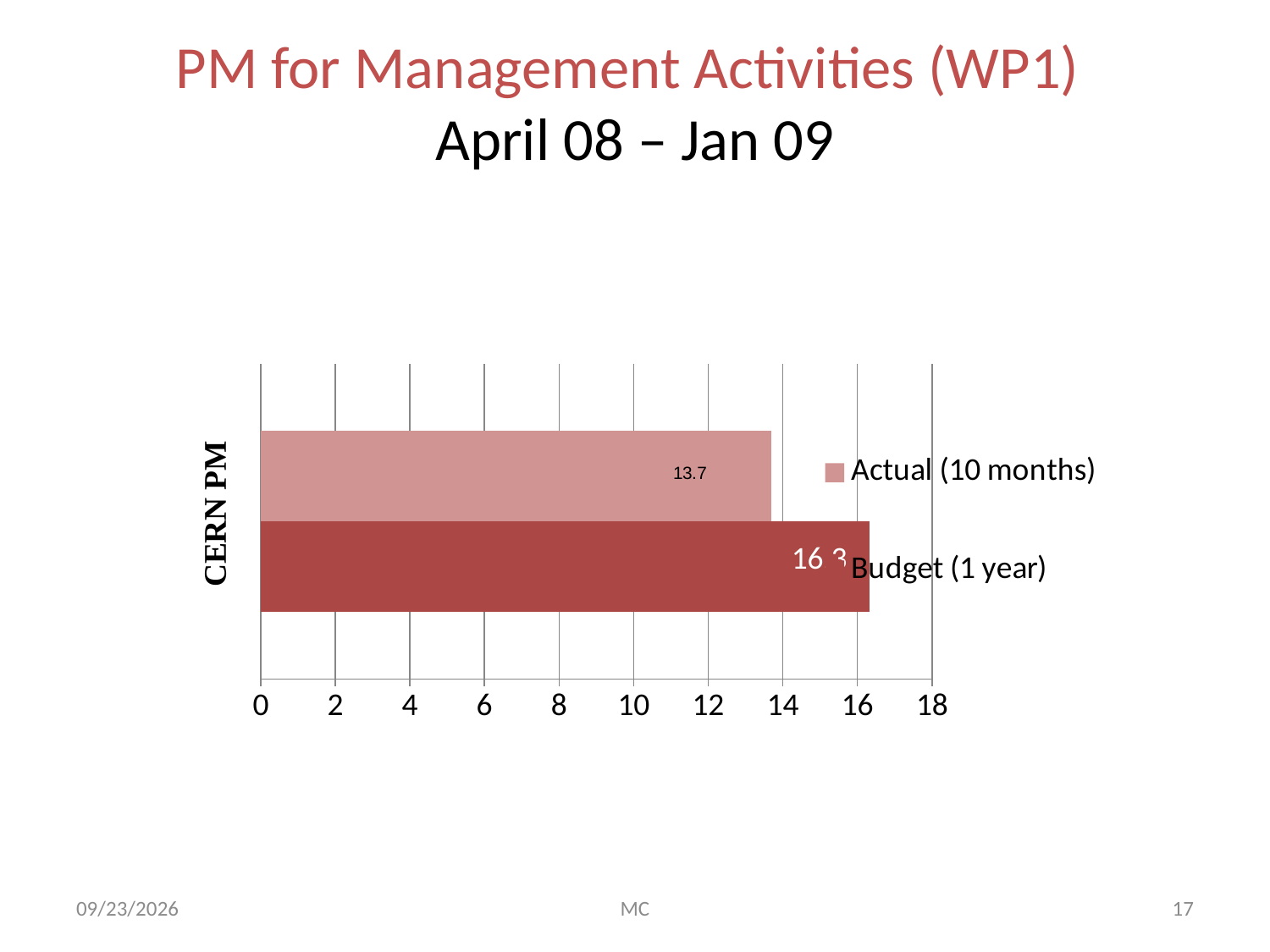
What is the maximum value shown on the horizontal axis of the chart? 18 What is the value of the Actual (10 months) bar for CERN PM? 13.7 What kind of chart is shown on the slide? bar chart What is the label of the category on the vertical axis? CERN PM Is the value of the Budget (1 year) bar greater or less than 16? greater Is the value of the Actual (10 months) bar greater or less than 14? less Which series has the larger value for CERN PM, Actual (10 months) or Budget (1 year)? Budget (1 year) How many categories are shown on the vertical axis of the chart? 1 Is the value of the Budget (1 year) bar greater or less than 18? less How many series does the legend list? 2 Which series is the lowest for CERN PM? Actual (10 months)